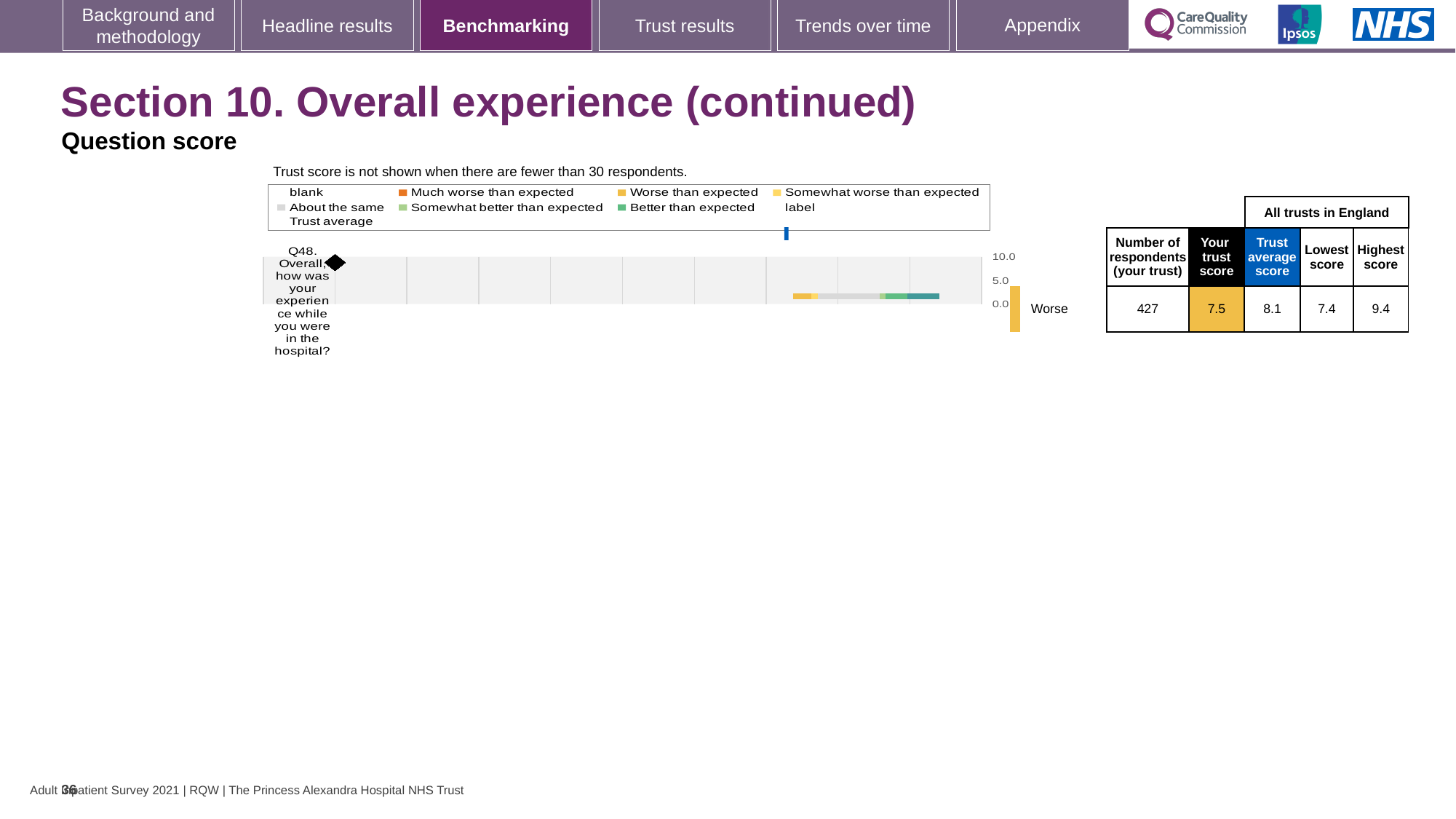
What is the trust score for Q48 according to the table? 7.5 What is the highest value shown on the chart's axis? 10.0 What is the highest score among all trusts in England for Q48? 9.4 How many respondents from the trust answered Q48? 427 Which is larger for Q48, the trust score or the trust average score? Trust average score What is the trust average score for Q48? 8.1 What kind of chart is shown on the slide? bar chart Is the trust score for Q48 greater or less than 5.0? greater How many survey questions are plotted in the chart? 1 What is the difference between the trust average score and the trust score for Q48? 0.6 What is the lowest score among all trusts in England for Q48? 7.4 Which question is plotted in the chart? Q48. Overall, how was your experience while you were in the hospital?